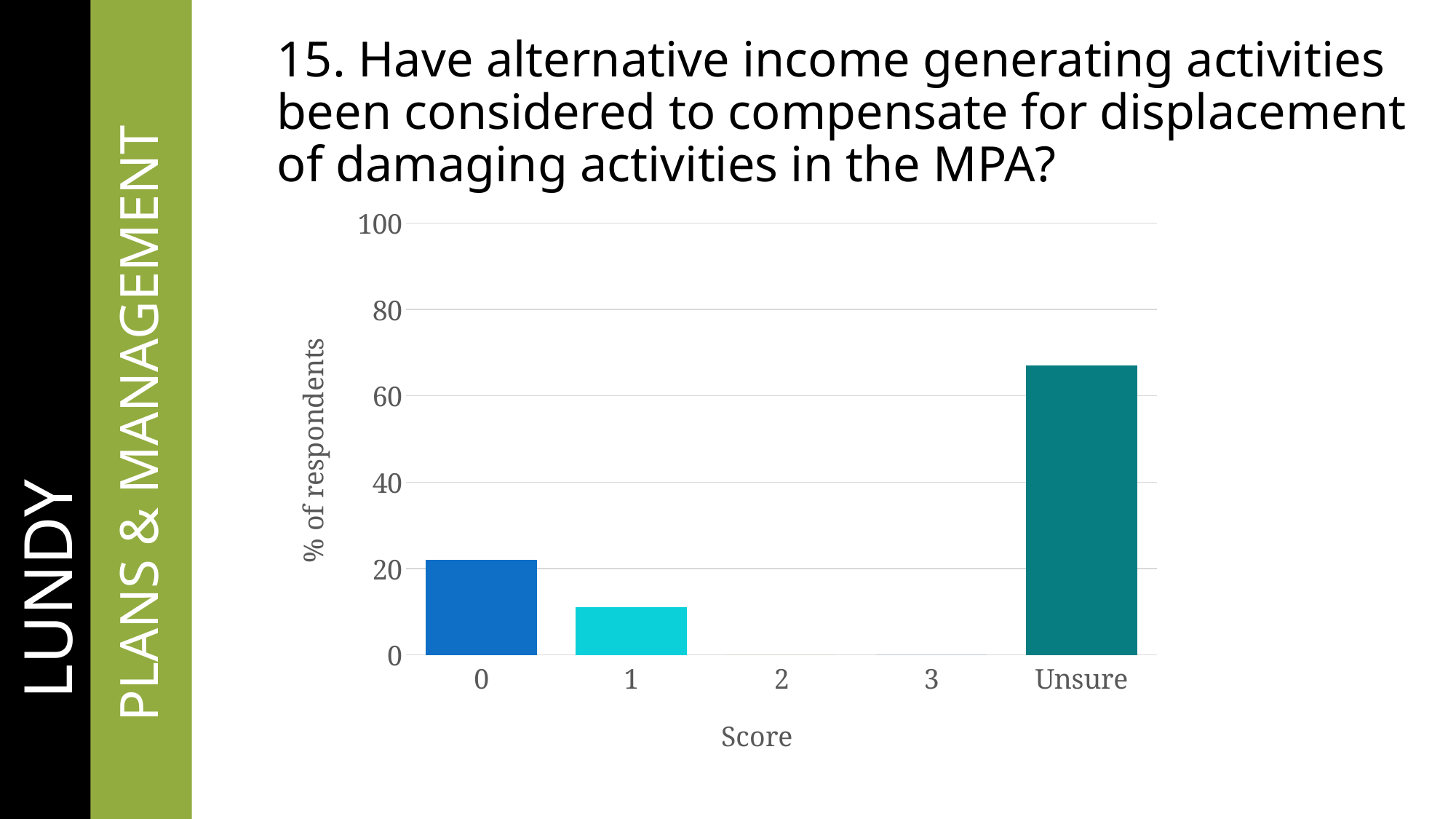
Is the value for score 0 greater or less than 40? less What is the label of the y axis? % of respondents How many categories are shown on the x axis of the chart? 5 Is the value for score 1 greater or less than 20? less What is the percentage of respondents for score 2? 0 Which category has the highest percentage of respondents? Unsure Is the value for Unsure greater or less than 80? less What is the title of the x axis? Score Which has a higher percentage of respondents, score 1 or Unsure? Unsure What kind of chart is shown on the slide? bar chart Which has a higher percentage of respondents, score 0 or score 1? 0